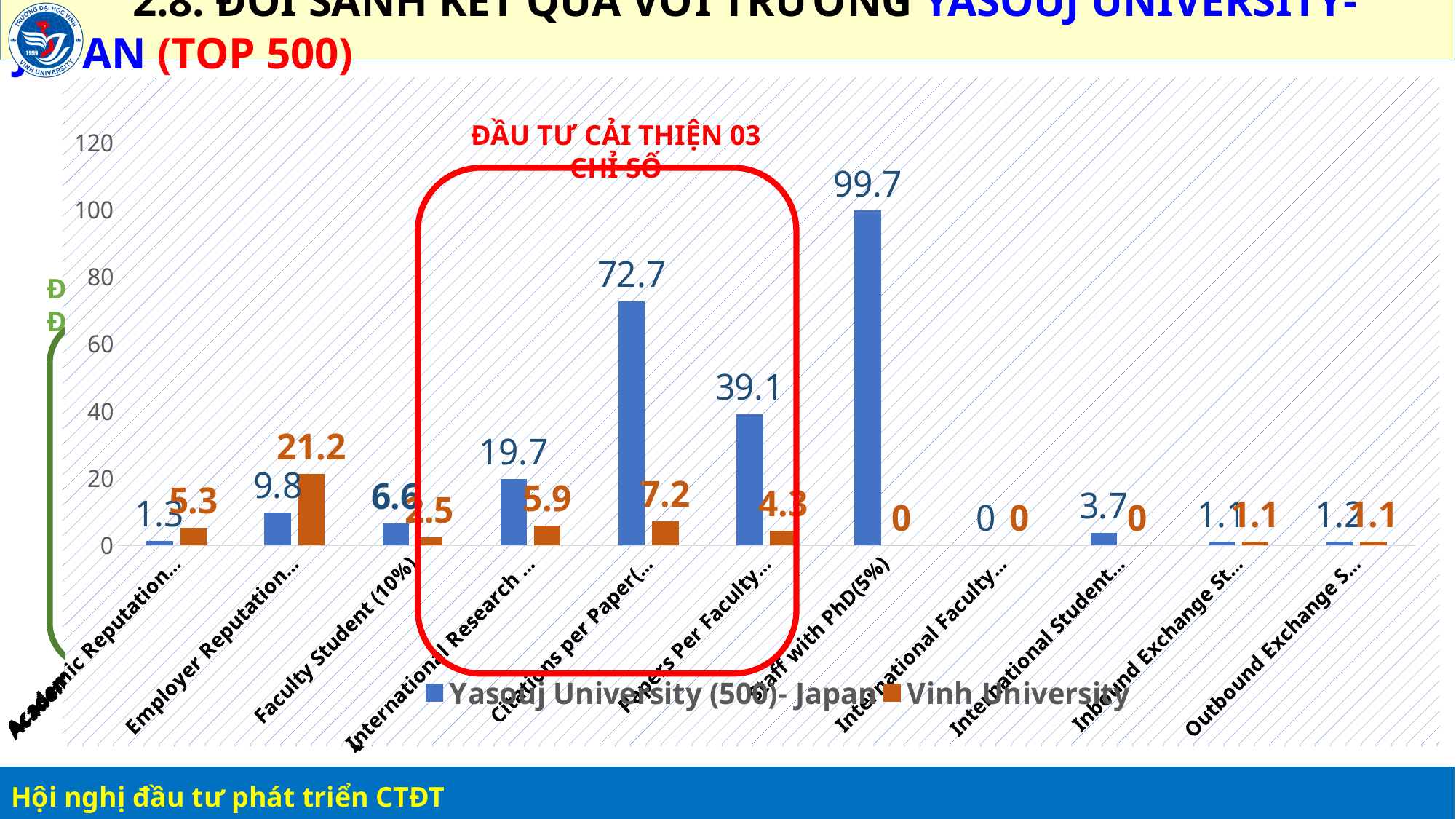
What is the value for Vinh University in the Employer Reputation category? 21.2 In the Faculty Student (10%) category, which series has the larger value, Yasouj University (500)- Japan or Vinh University? Yasouj University (500)- Japan How many categories are shown on the x axis? 11 How many series does the legend list? 2 What is the value for Yasouj University (500)- Japan in the Staff with PhD(5%) category? 99.7 What is the difference between the Yasouj University and Vinh University values in the Papers Per Faculty category? 34.8 What kind of chart is shown on the slide? Bar chart What is the value for Yasouj University (500)- Japan in the Citations per Paper category? 72.7 In which category does Vinh University have its highest value? Employer Reputation What is the value for Vinh University in the Papers Per Faculty category? 4.3 What is the difference between the Yasouj University and Vinh University values in the Citations per Paper category? 65.5 In which category does Yasouj University (500)- Japan have its highest value? Staff with PhD(5%)